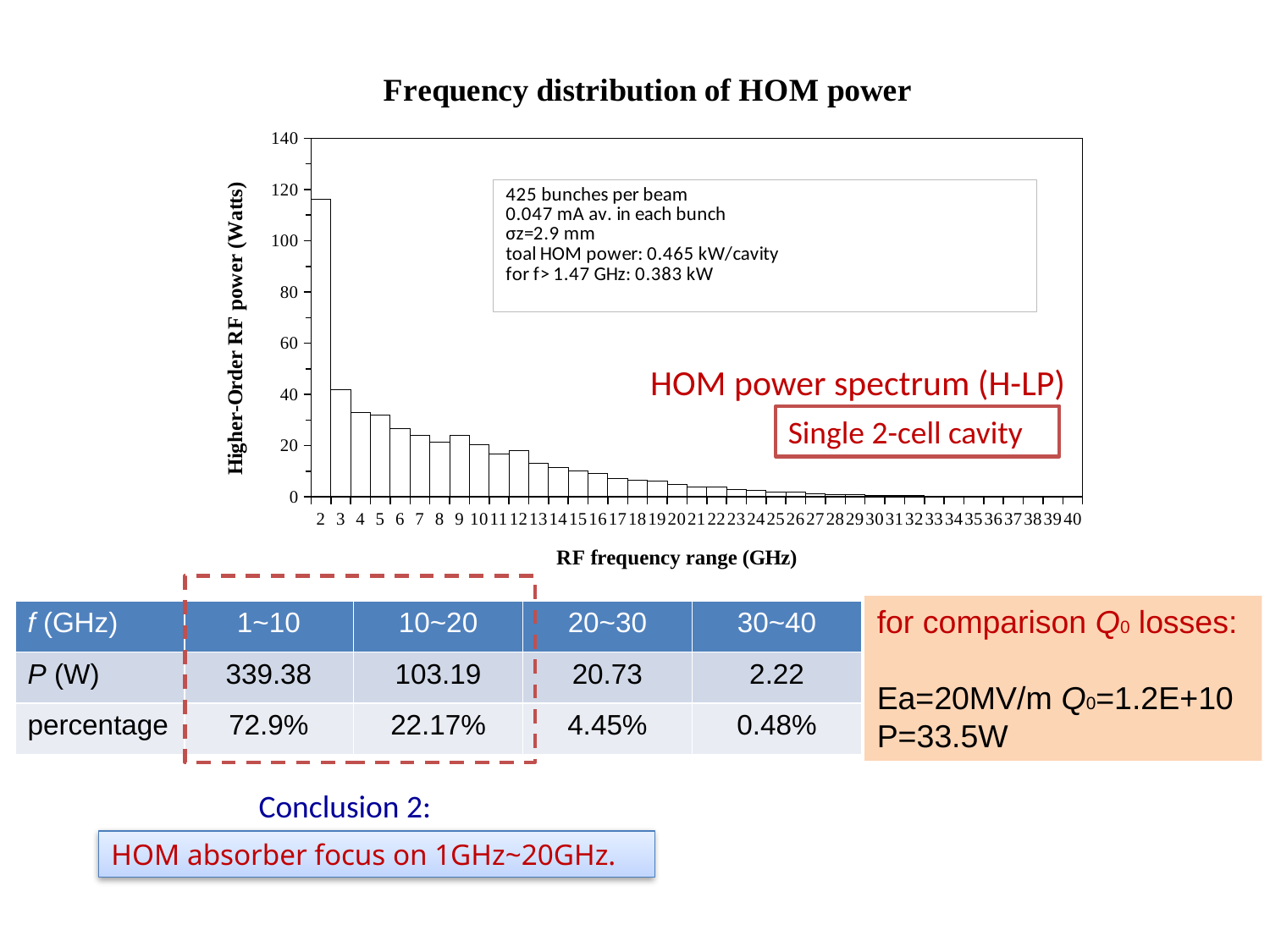
Is the value for the 20 GHz bar greater or less than 20? less What is the title of the chart? Frequency distribution of HOM power Which RF frequency range has the highest Higher-Order RF power? 2 Is the value for the 2 GHz bar greater or less than 100? greater Which is larger, the value for 5 GHz or the value for 10 GHz? 5 GHz Which is larger, the value for 2 GHz or the value for 3 GHz? 2 GHz Is the value for the 3 GHz bar greater or less than 20? greater What is the label of the y axis of the chart? Higher-Order RF power (Watts) What kind of chart is shown on the slide? bar chart Do the values generally rise or fall as the RF frequency increases along the x axis? fall